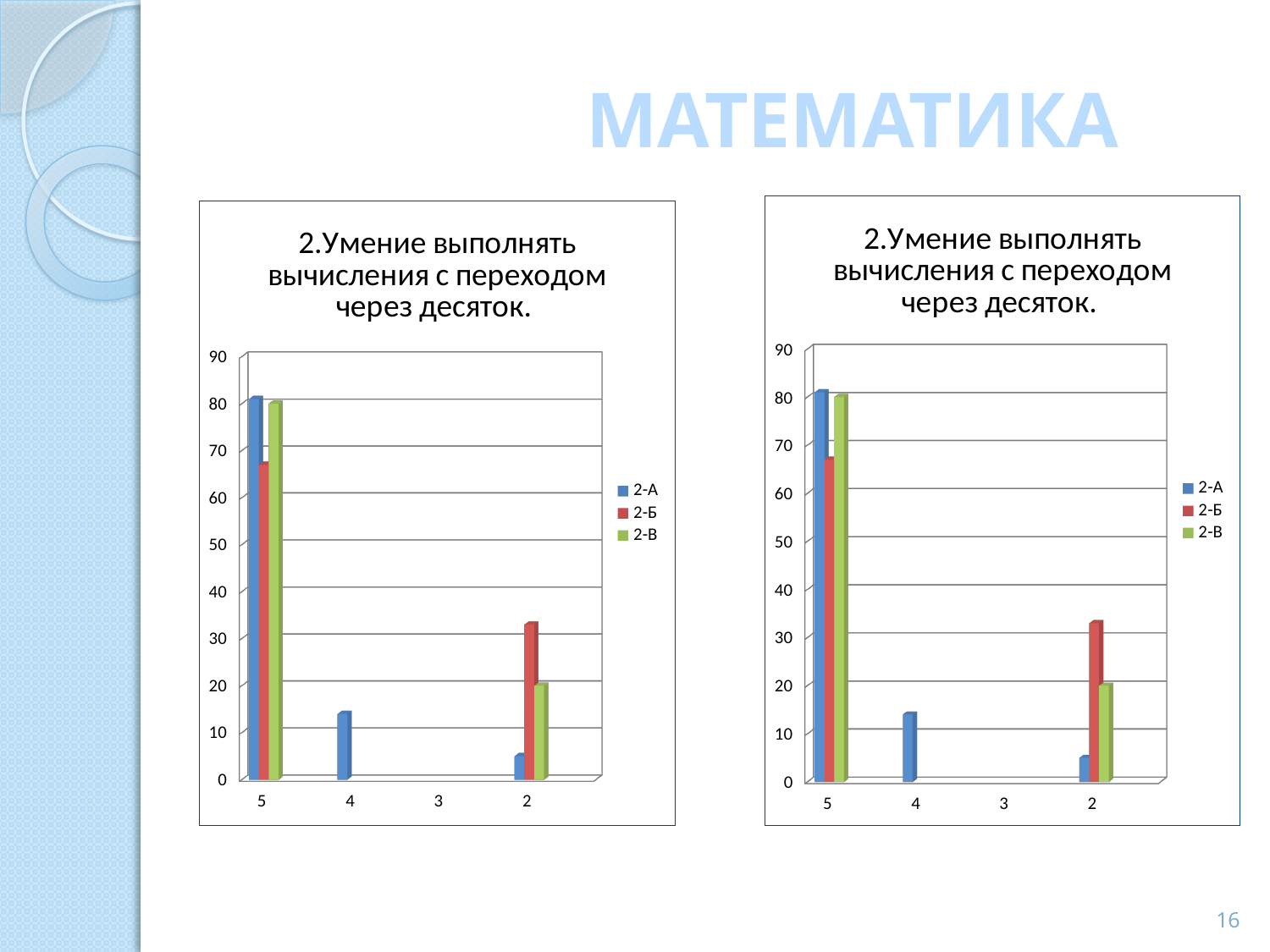
On the left chart, what kind of chart is shown? bar chart On the left chart, is the value for 2-Б at category 2 greater or less than 40? less On the left chart, is the value for 2-А at category 5 greater or less than 70? greater On the right chart, is the value for 2-А at category 4 greater or less than 20? less On the left chart, which is larger at category 2: the value for 2-В or the value for 2-А? 2-В On the right chart, which category has no bars at all? 3 On the left chart, which series has the highest value at category 2? 2-Б On the right chart, how many series does the legend list? 3 What is the title of the right chart? 2.Умение выполнять вычисления с переходом через десяток. On the left chart, how many categories are shown on the x axis? 4 On the right chart, which series has the lowest value at category 5? 2-Б